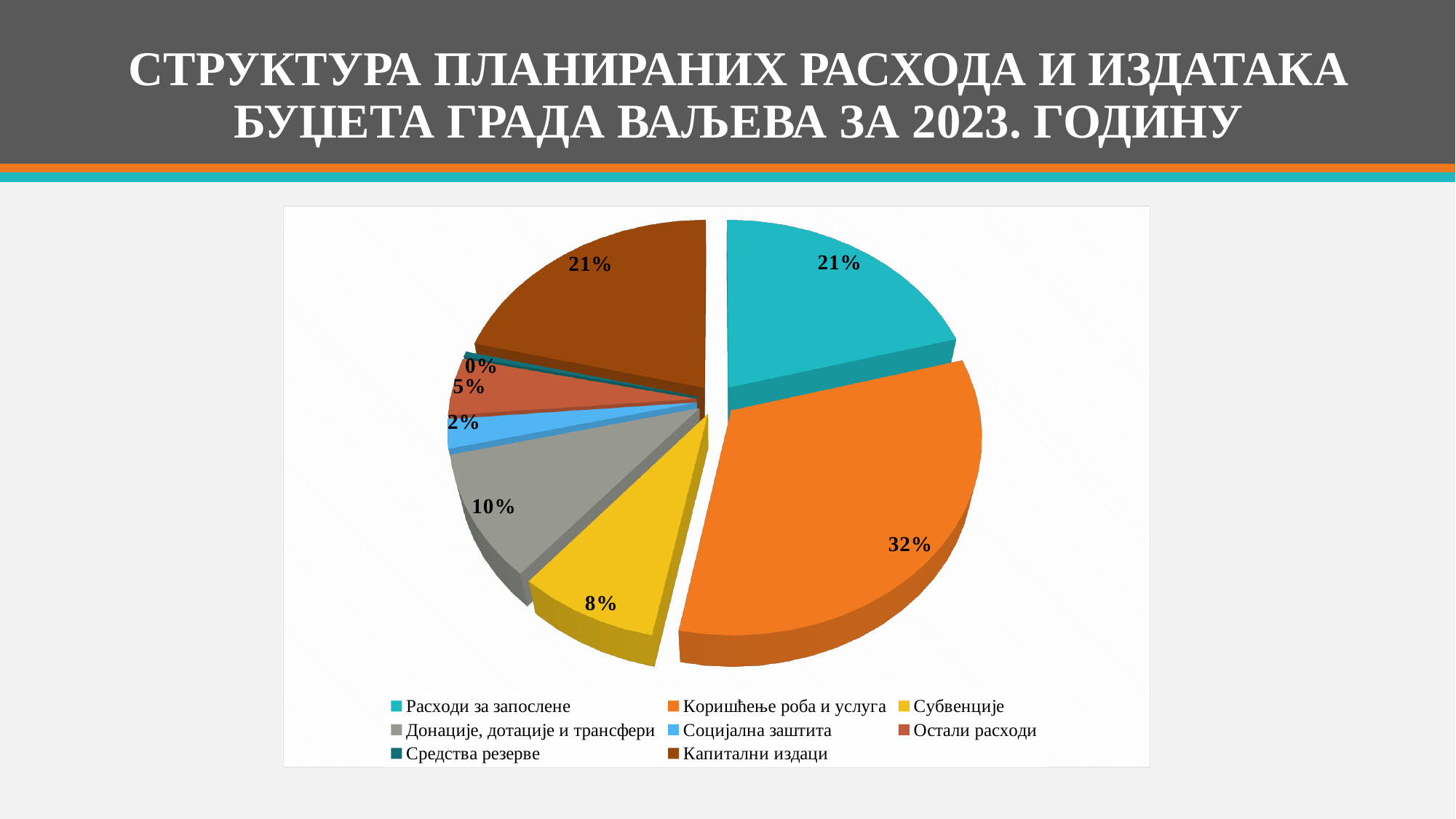
Which has a larger share, Донације, дотације и трансфери or Субвенције? Донације, дотације и трансфери What share of the pie does Остали расходи have? 5% What is the difference between the shares of Коришћење роба и услуга and Капитални издаци? 11% What share of the pie does Субвенције have? 8% What share of the pie does Коришћење роба и услуга have? 32% Which category has the smallest share of the pie? Средства резерве Which category has the largest share of the pie? Коришћење роба и услуга What kind of chart is shown on the slide? Pie chart How many categories does the legend list? 8